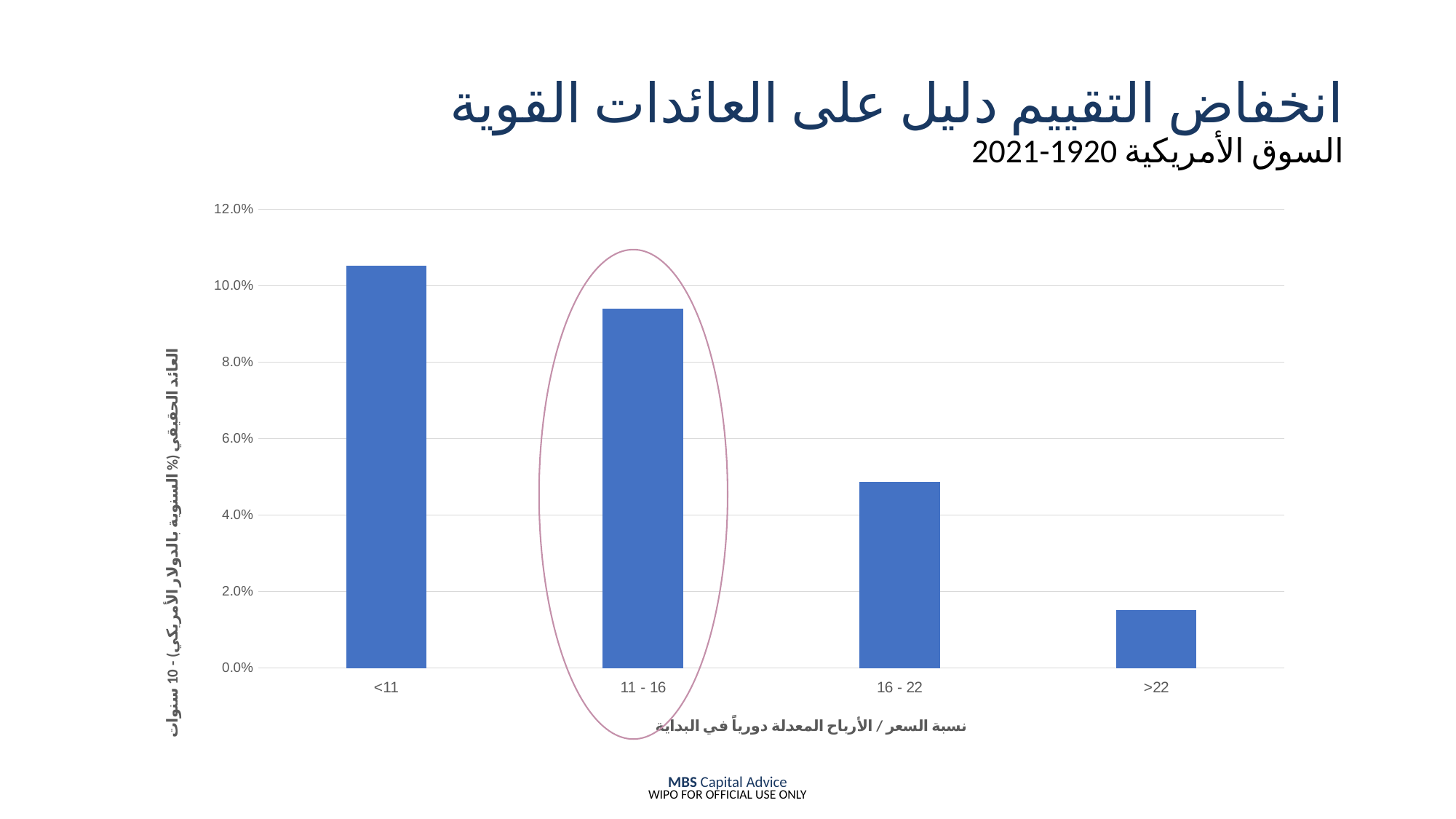
Is the value for 11 - 16 greater or less than 10.0%? less Which category's bar is circled on the chart? 11 - 16 How many categories are shown on the x axis of the chart? 4 Which category has the highest bar in the chart? <11 Is the value for <11 greater or less than 10.0%? greater Is the value for 16 - 22 greater or less than 6.0%? less Which category has the lowest bar in the chart? >22 What year range is given in the slide subtitle? 1920-2021 Do the bar values rise or fall moving from left to right along the x axis? fall What kind of chart is shown on the slide? bar chart Which is larger, the value for 11 - 16 or the value for 16 - 22? 11 - 16